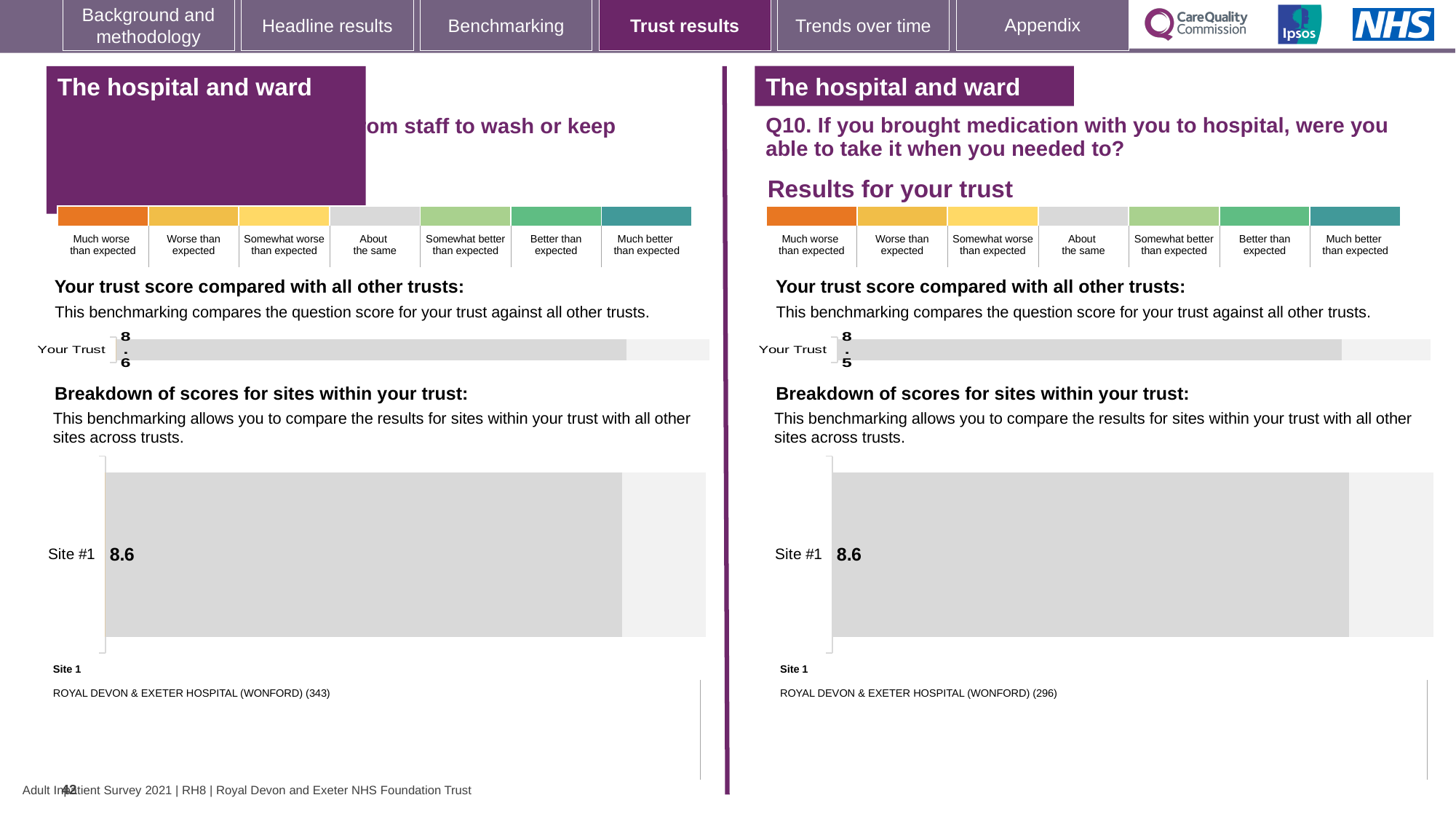
How many sites are shown in the 'Breakdown of scores for sites within your trust' chart on the left-hand side of the slide? 1 How many sites are shown in the 'Breakdown of scores for sites within your trust' chart on the right-hand side (Q10, medication)? 1 On the right-hand side (Q10, medication), what is the difference between the Site #1 score and the Your Trust score? 0.1 On the left-hand side of the slide, what is the score shown for Site #1 in the 'Breakdown of scores for sites within your trust' chart? 8.6 On the right-hand side (Q10, medication), what is the score shown for Site #1 in the 'Breakdown of scores for sites within your trust' chart? 8.6 What kind of chart is used to show the Site #1 score on the right-hand side (Q10, medication)? Bar chart On the right-hand side (Q10, medication), which is larger: the Your Trust score or the Site #1 score? Site #1 On the right-hand side (Q10, medication), which site is listed as Site 1 below the chart? ROYAL DEVON & EXETER HOSPITAL (WONFORD) (296) On the left-hand side of the slide, which site is listed as Site 1 below the chart? ROYAL DEVON & EXETER HOSPITAL (WONFORD) (343) On the right-hand side (Q10, medication), what is the score shown for Your Trust in the 'Your trust score compared with all other trusts' chart? 8.5 On the left-hand side of the slide, what is the score shown for Your Trust in the 'Your trust score compared with all other trusts' chart? 8.6 Is the Your Trust score on the right-hand side (Q10, medication) greater or less than the Site #1 score on the same side? less